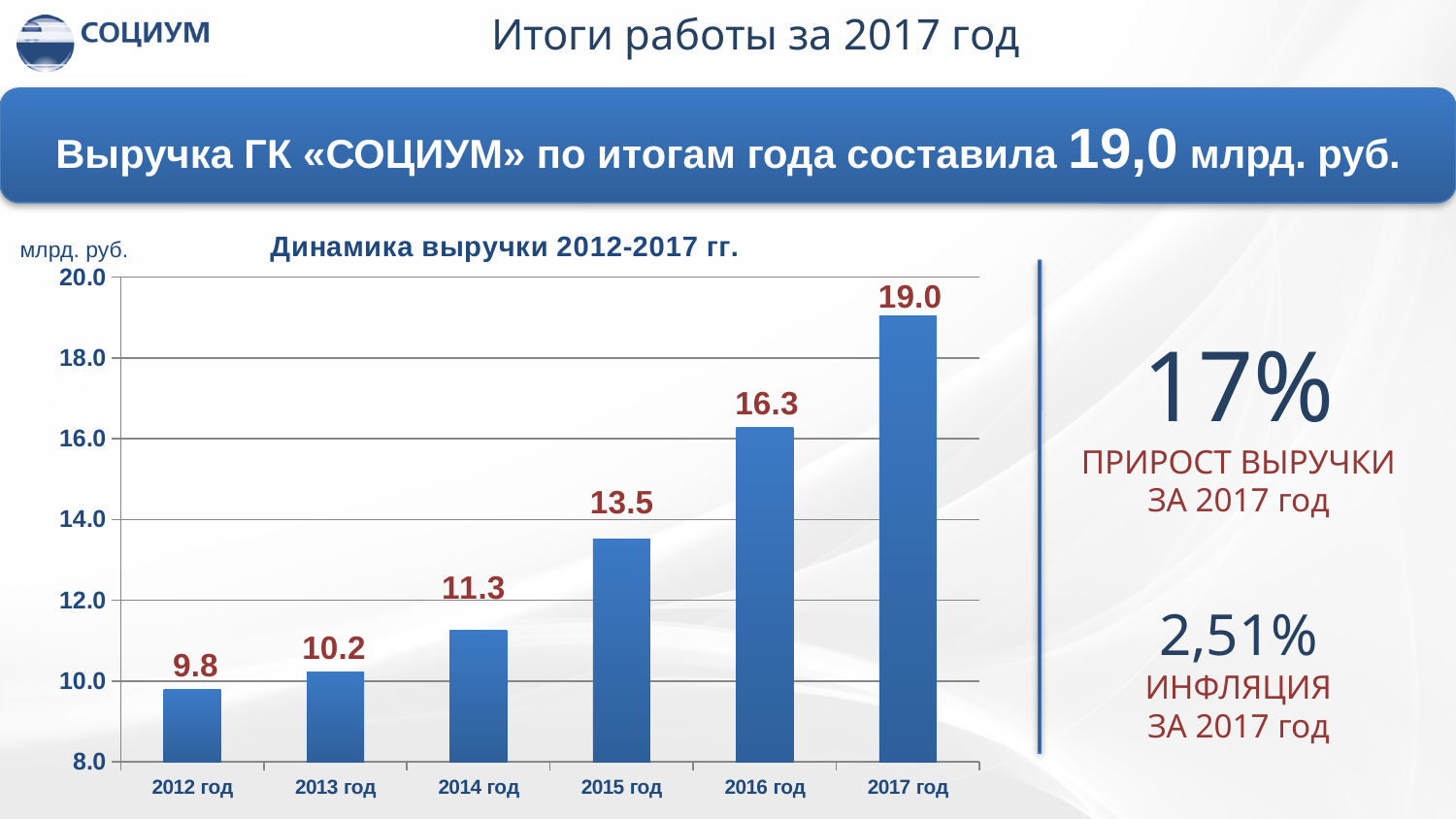
How many years are shown on the x axis of the chart? 6 What is the difference between the revenue for 2014 год and 2012 год? 1.5 What is the title of the chart? Динамика выручки 2012-2017 гг. What is the revenue value shown for 2015 год? 13.5 Which year has the lowest revenue in the chart? 2012 год Which year has the highest revenue in the chart? 2017 год What kind of chart is shown on the slide? bar chart Do the revenue values rise or fall from 2012 год to 2017 год? rise Is the value for 2016 год greater or less than 16.0? greater What is the difference between the revenue for 2017 год and 2016 год? 2.7 Which is larger, the revenue for 2014 год or 2015 год? 2015 год What is the revenue value shown for 2013 год? 10.2